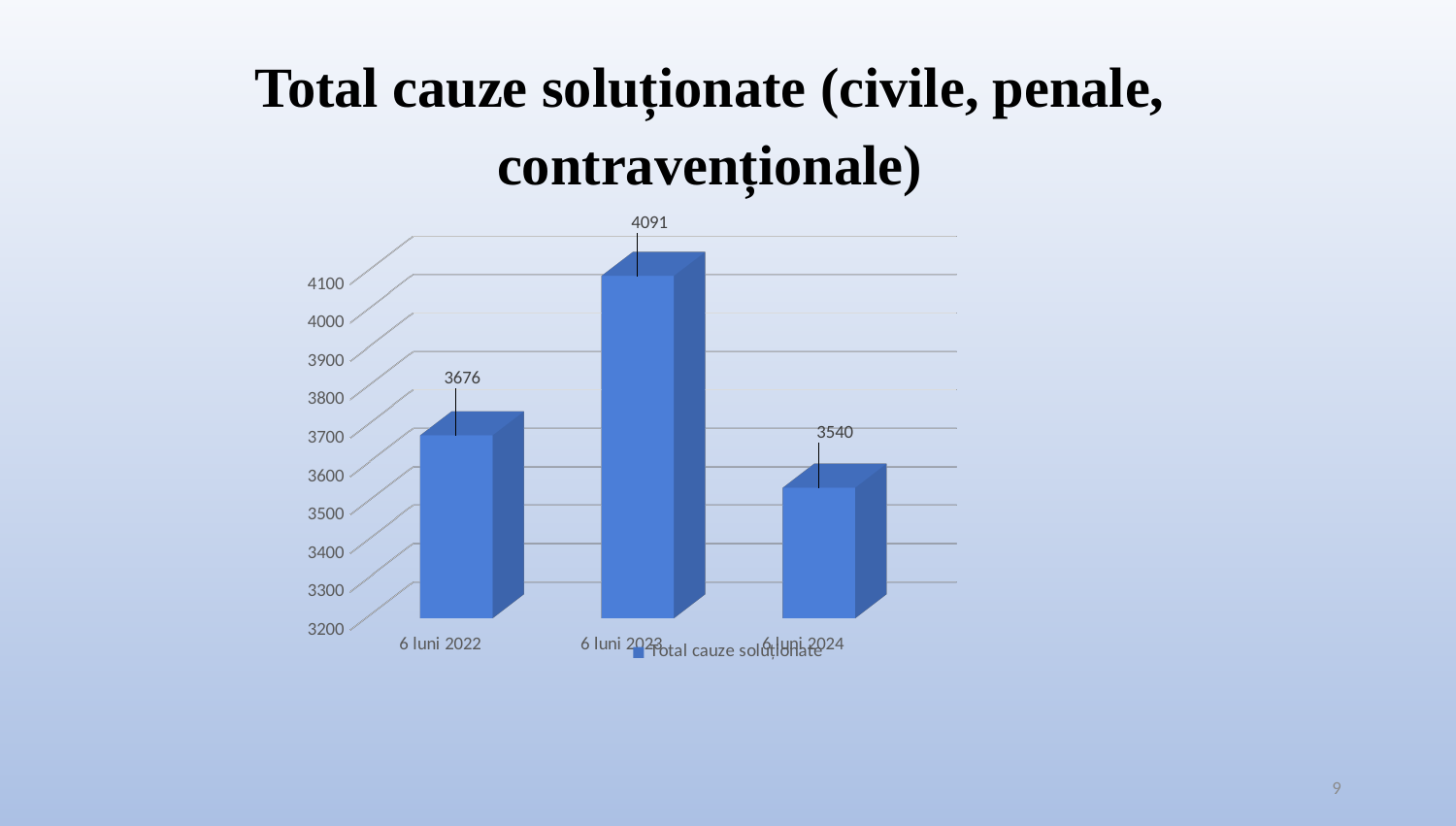
What is the value for 6 luni 2023? 4091 Which is larger, the value for 6 luni 2022 or the value for 6 luni 2024? 6 luni 2022 What is the difference between the values for 6 luni 2023 and 6 luni 2022? 415 What is the difference between the values for 6 luni 2022 and 6 luni 2024? 136 Is the value for 6 luni 2023 greater or less than 4000? greater What kind of chart is shown on the slide? bar chart What is the value for 6 luni 2024? 3540 What series name does the legend show? Total cauze soluționate How many categories are shown on the x axis? 3 Which category has the highest value? 6 luni 2023 What is the value for 6 luni 2022? 3676 Which category has the lowest value? 6 luni 2024